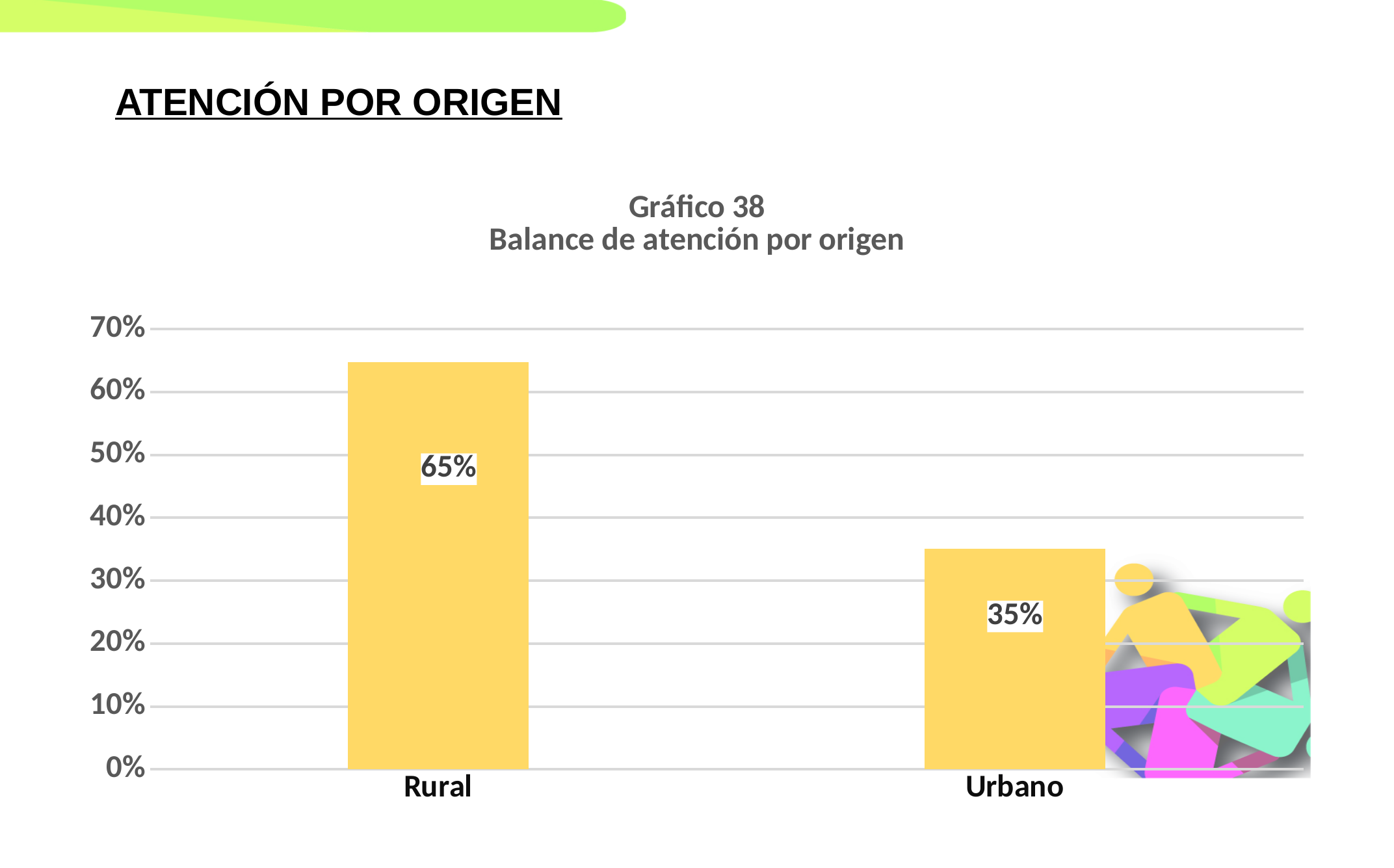
What is the difference between the values for Rural and Urbano? 30% Is the value for Rural greater or less than 60%? greater Is the value for Urbano greater or less than 40%? less What is the value for Urbano? 35% What is the value for Rural? 65% Which category has the lowest value? Urbano What kind of chart is shown on the slide? bar chart What is the title of the chart? Gráfico 38 Balance de atención por origen Which category has the highest value? Rural How many categories are shown on the x axis? 2 What is the highest value shown on the y axis? 70% Which is larger, the value for Rural or the value for Urbano? Rural